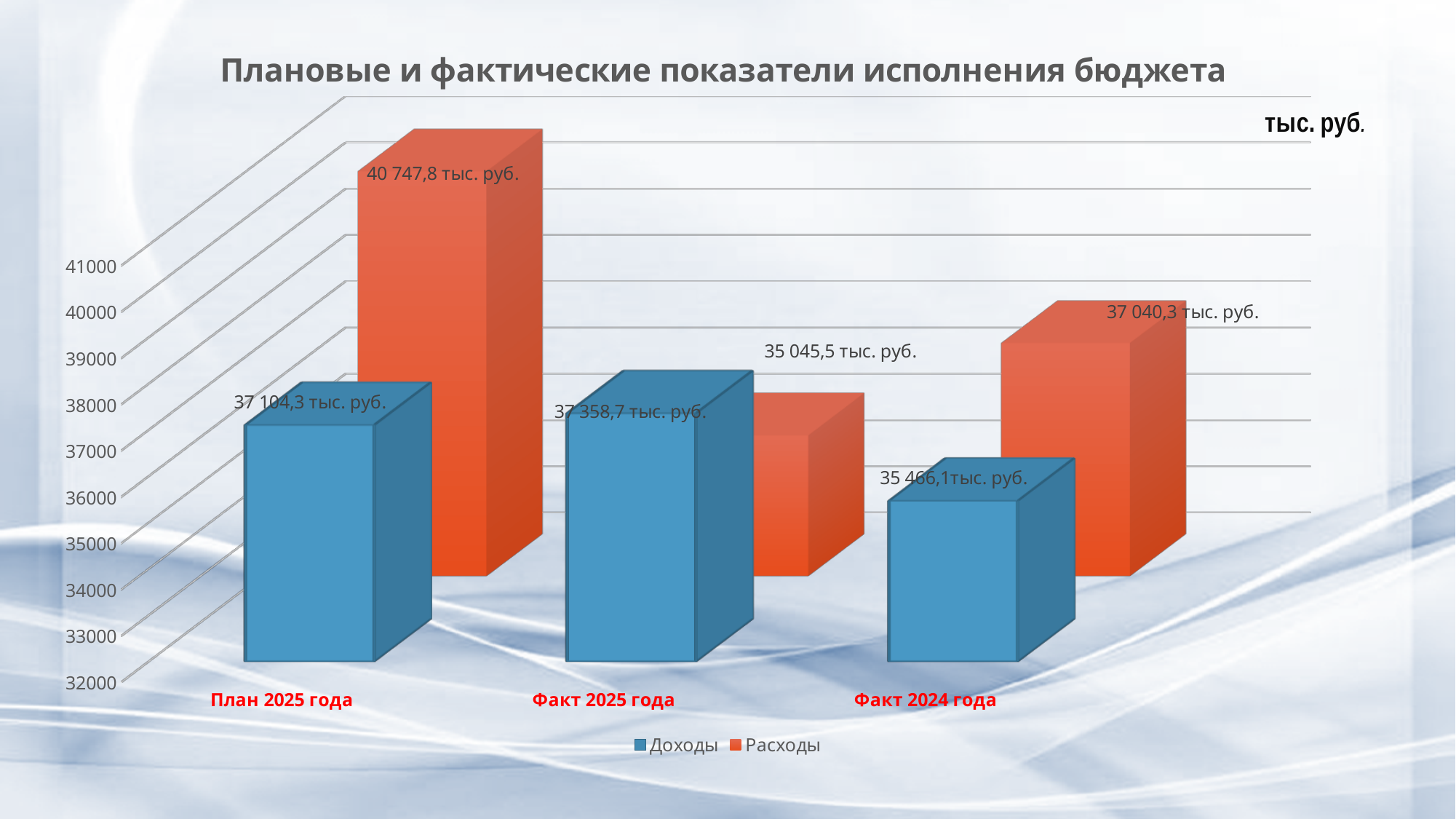
What is the value of Расходы for План 2025 года? 40 747,8 тыс. руб. How many series does the legend list? 2 What kind of chart is shown on the slide? Bar chart What is the difference between Доходы and Расходы for Факт 2025 года? 2 313,2 тыс. руб. What is the value of Расходы for Факт 2024 года? 37 040,3 тыс. руб. For Факт 2024 года, which is larger: Доходы or Расходы? Расходы Which category has the highest Расходы value? План 2025 года What is the value of Доходы for План 2025 года? 37 104,3 тыс. руб. What is the difference between Расходы and Доходы for План 2025 года? 3 643,5 тыс. руб. Which category has the lowest Доходы value? Факт 2024 года What is the value of Доходы for Факт 2025 года? 37 358,7 тыс. руб. How many categories are shown on the x axis? 3